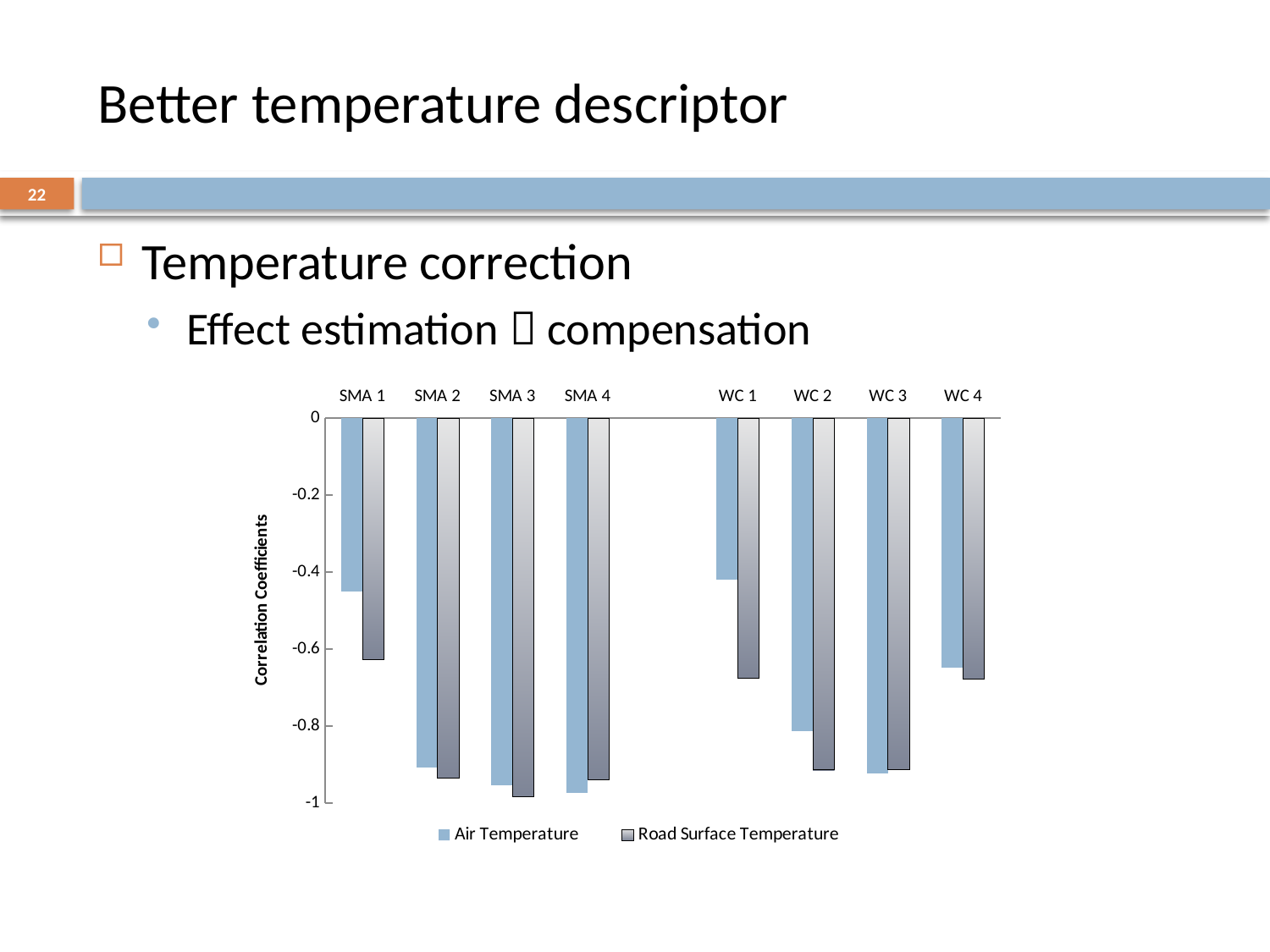
For WC 1, which series has the bar extending further below zero, Air Temperature or Road Surface Temperature? Road Surface Temperature Is the Road Surface Temperature value for WC 2 greater or less than -0.8? less Is the Road Surface Temperature value for SMA 2 greater or less than -0.8? less Is the Air Temperature value for WC 4 greater or less than -0.8? greater For SMA 1, which series has the bar extending further below zero, Air Temperature or Road Surface Temperature? Road Surface Temperature What kind of chart is shown on the slide? bar chart How many categories are shown along the x axis of the chart? 8 What are the two series named in the chart's legend? Air Temperature and Road Surface Temperature What is the title of the vertical axis of the chart? Correlation Coefficients How many series does the chart's legend list? 2